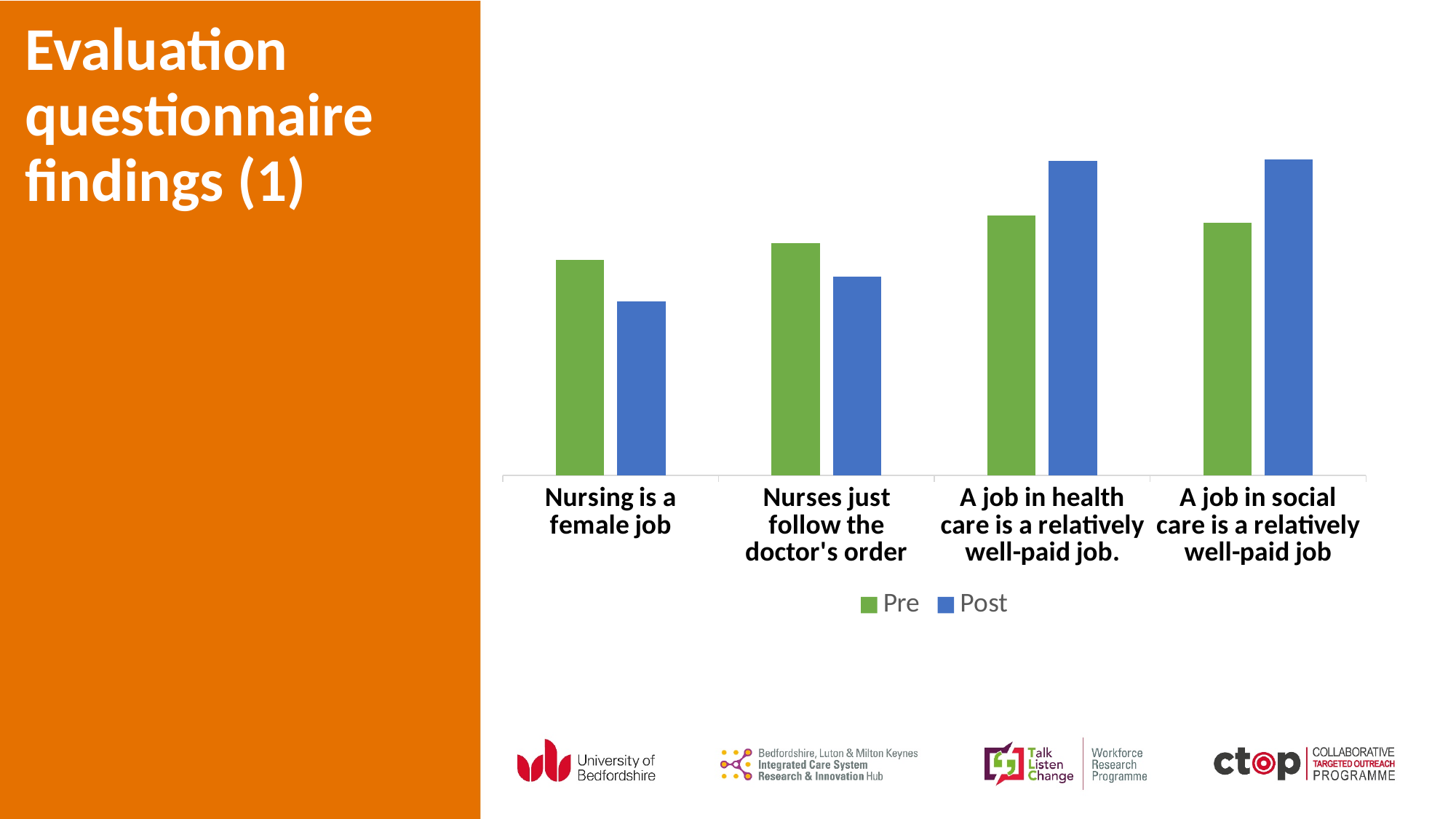
How many series does the chart's legend list? 2 For 'A job in health care is a relatively well-paid job.', which is larger, the Pre value or the Post value? Post Which category has the lowest Pre value? Nursing is a female job Which category has the lowest Post value? Nursing is a female job What kind of chart is shown on the slide? bar chart What are the two series named in the chart's legend? Pre and Post For 'Nursing is a female job', which is larger, the Pre value or the Post value? Pre For 'A job in social care is a relatively well-paid job', which is larger, the Pre value or the Post value? Post How many categories are shown on the x axis of the chart? 4 Which colour represents the Post series in the chart? blue